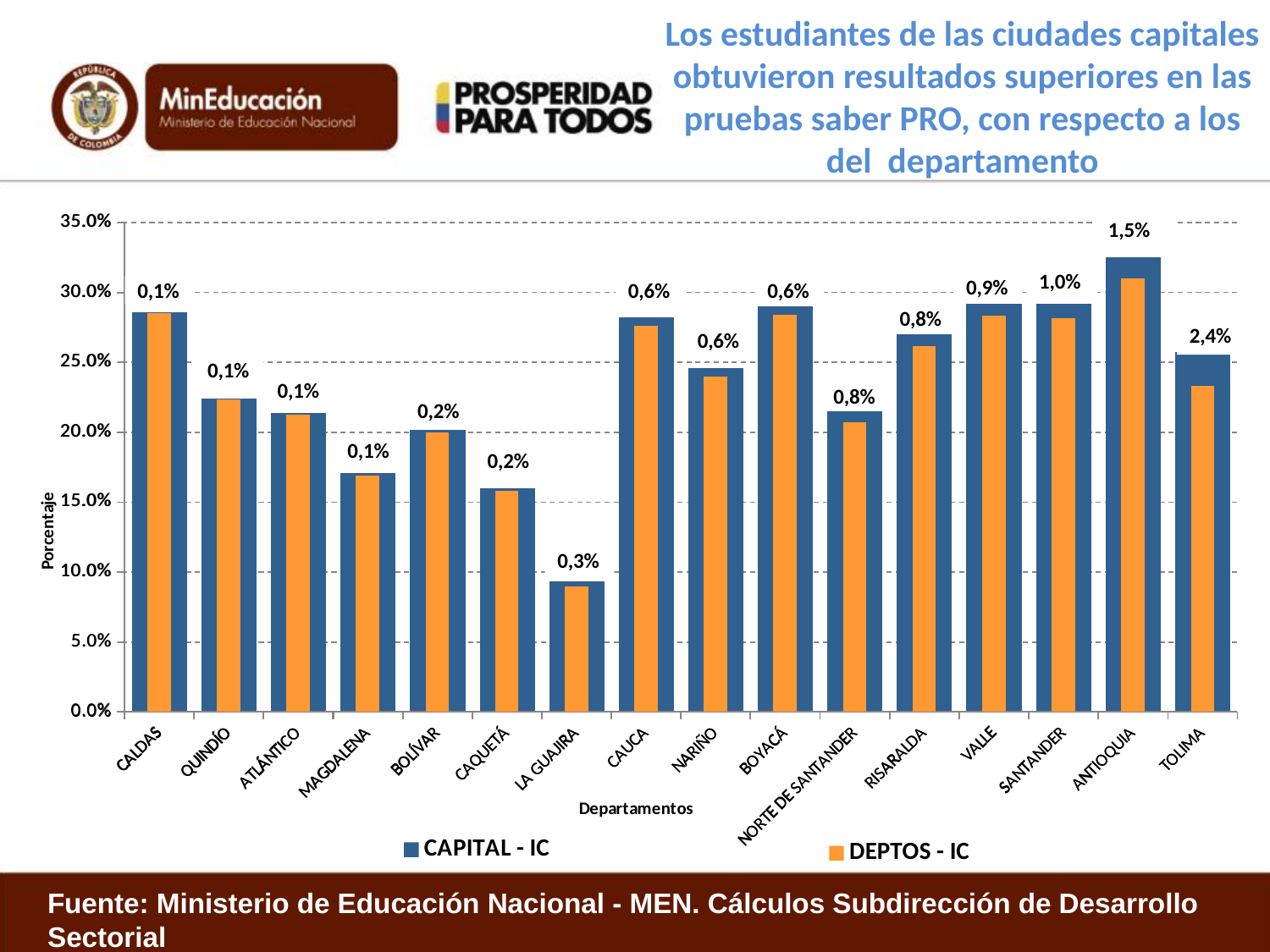
How many departments are shown on the x axis? 16 What is the data label printed above the bars for TOLIMA? 2,4% What kind of chart is shown on the slide? bar chart Which has the larger CAPITAL - IC value, CALDAS or QUINDÍO? CALDAS What is the data label printed above the bars for ANTIOQUIA? 1,5% How many series does the legend list? 2 Is the CAPITAL - IC value for LA GUAJIRA greater or less than 10.0%? less Which department has the lowest CAPITAL - IC bar? LA GUAJIRA What is the data label printed above the bars for LA GUAJIRA? 0,3% Which department has the largest printed data label? TOLIMA Which department has the highest CAPITAL - IC bar? ANTIOQUIA Is the CAPITAL - IC value for ANTIOQUIA greater or less than 30.0%? greater